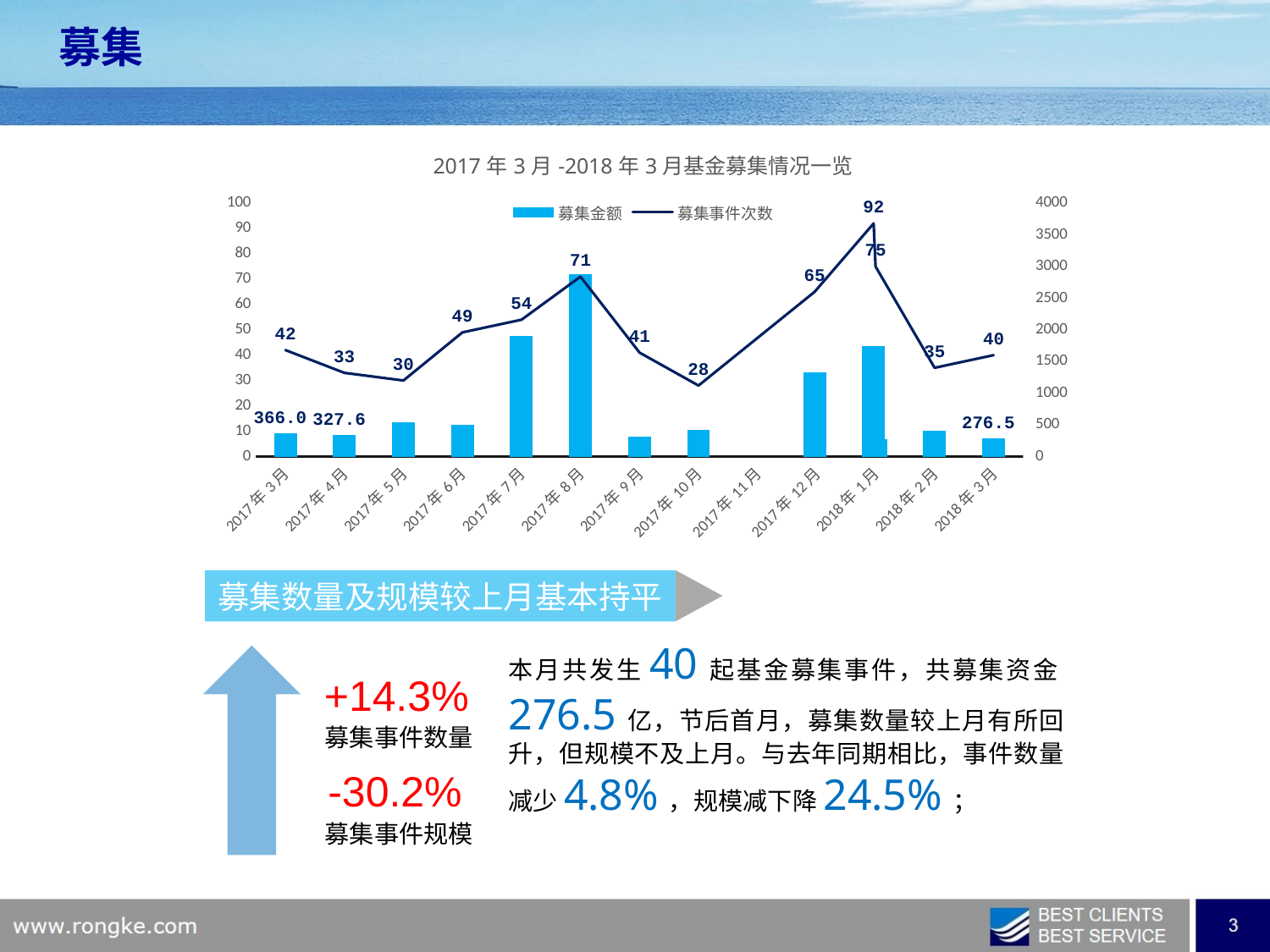
What kind of chart is shown on the slide? A combined bar and line chart Which month has the larger 募集事件次数, 2017年6月 or 2017年7月? 2017年7月 What is the 募集金额 value labelled for 2017年3月? 366.0 How many series does the chart legend list? 2 How many months are shown along the x axis of the chart? 13 Is the 募集金额 bar for 2017年8月 greater or less than 2500 on the right axis? greater Which month has the lowest 募集事件次数 on the line? 2017年10月 What is the difference between the 募集金额 labels for 2017年3月 and 2017年4月? 38.4 What is the 募集事件次数 value for 2017年8月? 71 What is the 募集事件次数 value for 2017年10月? 28 What is the 募集金额 value labelled for 2018年3月? 276.5